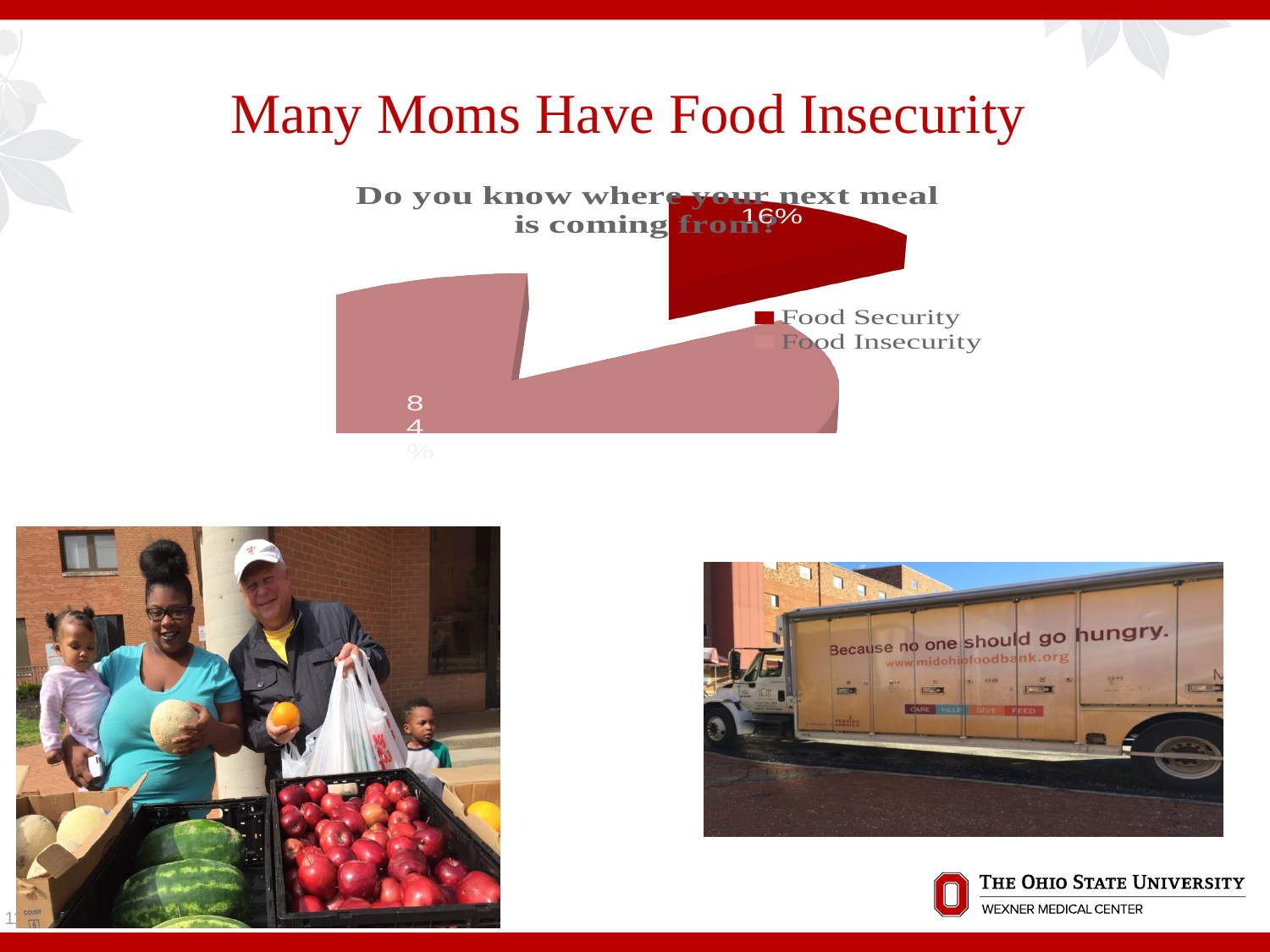
What is the difference in percentage points between the Food Insecurity and Food Security slices? 68 How many categories does the legend of the pie chart list? 2 What is the title of the pie chart? Do you know where your next meal is coming from? Is the share for Food Insecurity greater or less than 50%? greater Is the share for Food Security greater or less than 25%? less Which category has the largest share of the pie chart? Food Insecurity What percentage of the pie chart is labelled for the pink slice (Food Insecurity)? 84% What percentage of the pie chart is labelled for the dark red slice (Food Security)? 16% Which legend entry is shown in dark red in the pie chart? Food Security Which category has the smallest share of the pie chart? Food Security Which is larger in the pie chart, Food Security or Food Insecurity? Food Insecurity What kind of chart is shown on the slide? pie chart